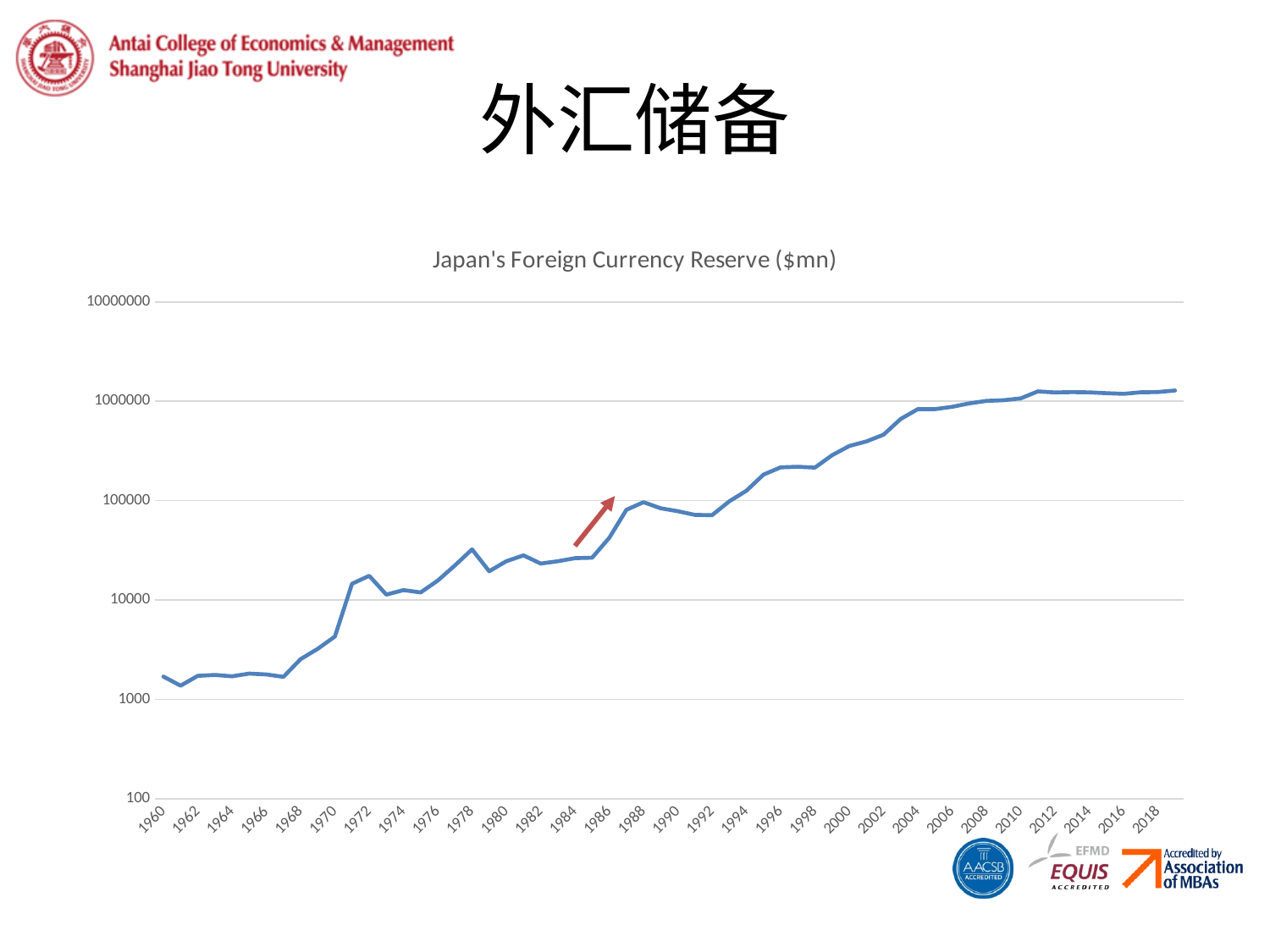
What is the title of the chart? Japan's Foreign Currency Reserve ($mn) Is the value for 1978 greater or less than 100000? less Is the value for 1960 greater or less than 10000? less What kind of chart is shown on the slide? line chart Is the value for 1972 greater or less than 10000? greater What is the first year shown on the x axis? 1960 Which year has the larger value, 1970 or 2000? 2000 Overall, do the values rise or fall from 1960 to 2018? rise